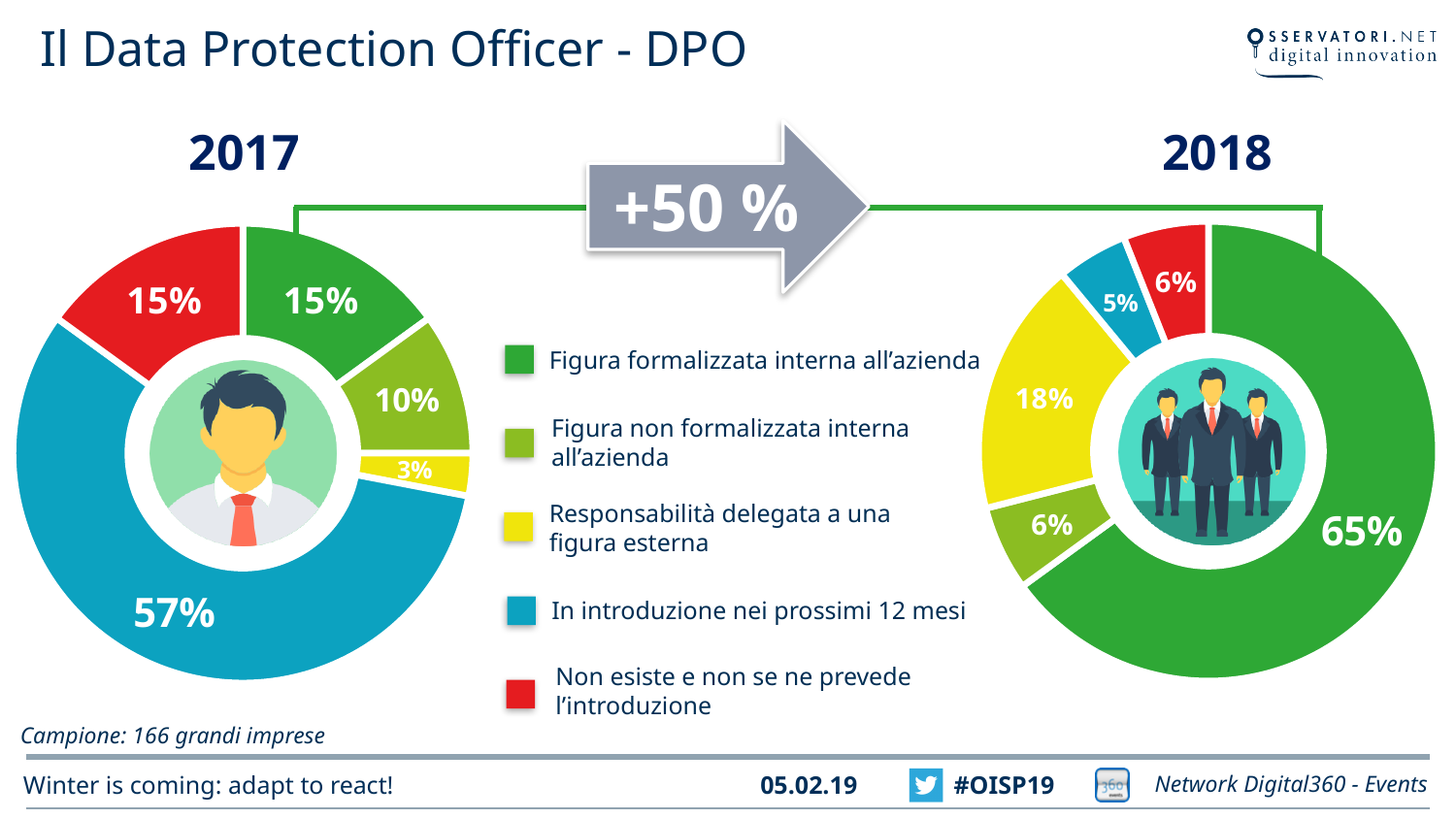
In the 2017 chart, what is the combined share of "Figura formalizzata interna all'azienda" and "Figura non formalizzata interna all'azienda"? 25% In the 2017 chart, which category has the largest share? In introduzione nei prossimi 12 mesi In the 2018 chart, which is larger: "Responsabilità delegata a una figura esterna" or "Non esiste e non se ne prevede l'introduzione"? Responsabilità delegata a una figura esterna What percentage change is shown on the arrow between the 2017 and 2018 charts? +50 % How many categories does the legend list for the charts? 5 What is the difference between the value for "Figura formalizzata interna all'azienda" in the 2018 chart and in the 2017 chart? 50 percentage points In the 2017 chart, what is the value for "Responsabilità delegata a una figura esterna"? 3% In the 2018 chart, which category has the smallest share? In introduzione nei prossimi 12 mesi In the 2018 chart, what is the value for "Figura formalizzata interna all'azienda"? 65% What kind of chart is used for the 2017 and 2018 data? Pie (donut) chart In the 2018 chart, what is the value for "Responsabilità delegata a una figura esterna"? 18% In the 2017 chart, what is the value for "In introduzione nei prossimi 12 mesi"? 57%